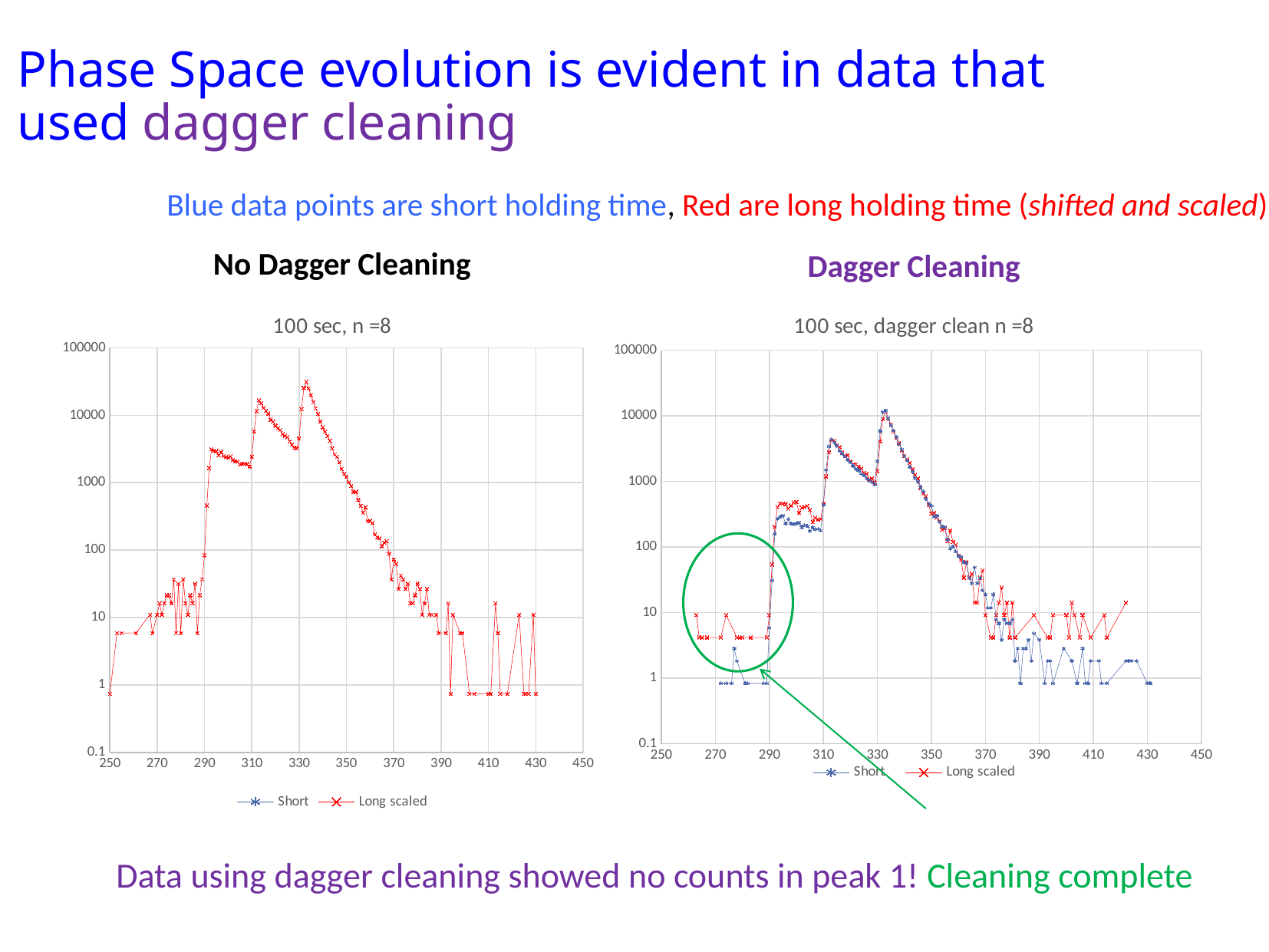
In the right chart "100 sec, dagger clean n =8", are the Short series values around x = 400 greater or less than 10? less What kind of chart is the left chart titled "100 sec, n =8"? line chart How many series does the legend of the right chart "100 sec, dagger clean n =8" list? 2 In the left chart "100 sec, n =8", do the values rise or fall as x goes from 330 to 390? fall In the right chart "100 sec, dagger clean n =8", is the peak near x = 313 greater or less than 10000? less In the right chart "100 sec, dagger clean n =8", is the peak near x = 313 greater or less than 1000? greater What is the title of the chart under the heading "Dagger Cleaning"? 100 sec, dagger clean n =8 How many charts are shown on the slide? 2 What are the two legend entries on the left chart "100 sec, n =8"? Short, Long scaled In the left chart "100 sec, n =8", which peak is higher: the one near x = 310 or the one near x = 330? the one near x = 330